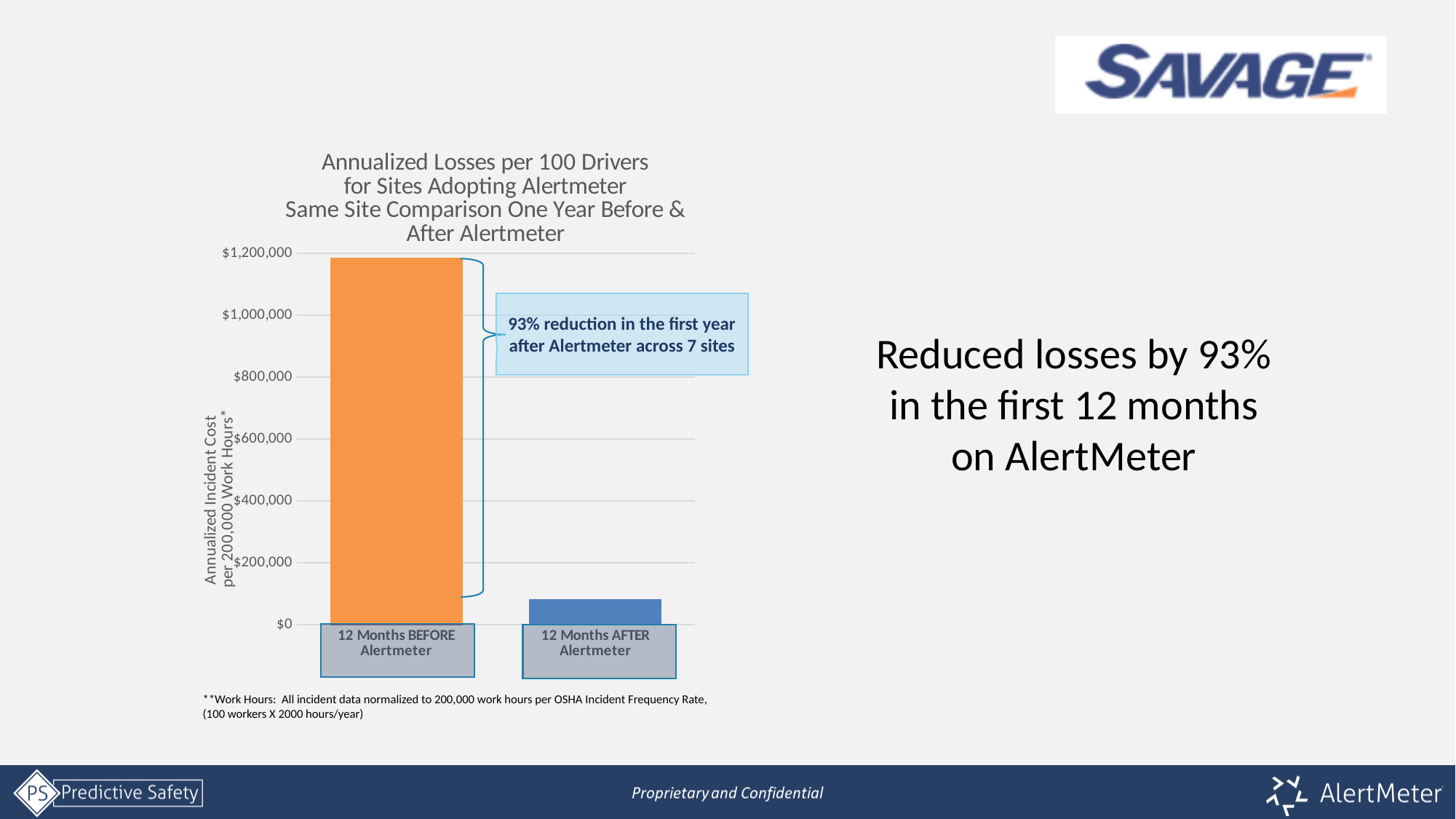
How many bars (categories) does the chart show? 2 Is the value for 12 Months BEFORE Alertmeter greater or less than $1,000,000? greater Which is larger, the value for 12 Months BEFORE Alertmeter or the value for 12 Months AFTER Alertmeter? 12 Months BEFORE Alertmeter Which category has the highest annualized incident cost? 12 Months BEFORE Alertmeter Is the value for 12 Months AFTER Alertmeter greater or less than $200,000? less What is the highest value shown on the y axis of the chart? $1,200,000 Which category has the lowest annualized incident cost? 12 Months AFTER Alertmeter Is the value for 12 Months BEFORE Alertmeter greater or less than $800,000? greater According to the callout on the chart, what percentage reduction occurred in the first year after Alertmeter? 93% What kind of chart is shown on the slide? bar chart Do the values rise or fall from the BEFORE bar to the AFTER bar? fall